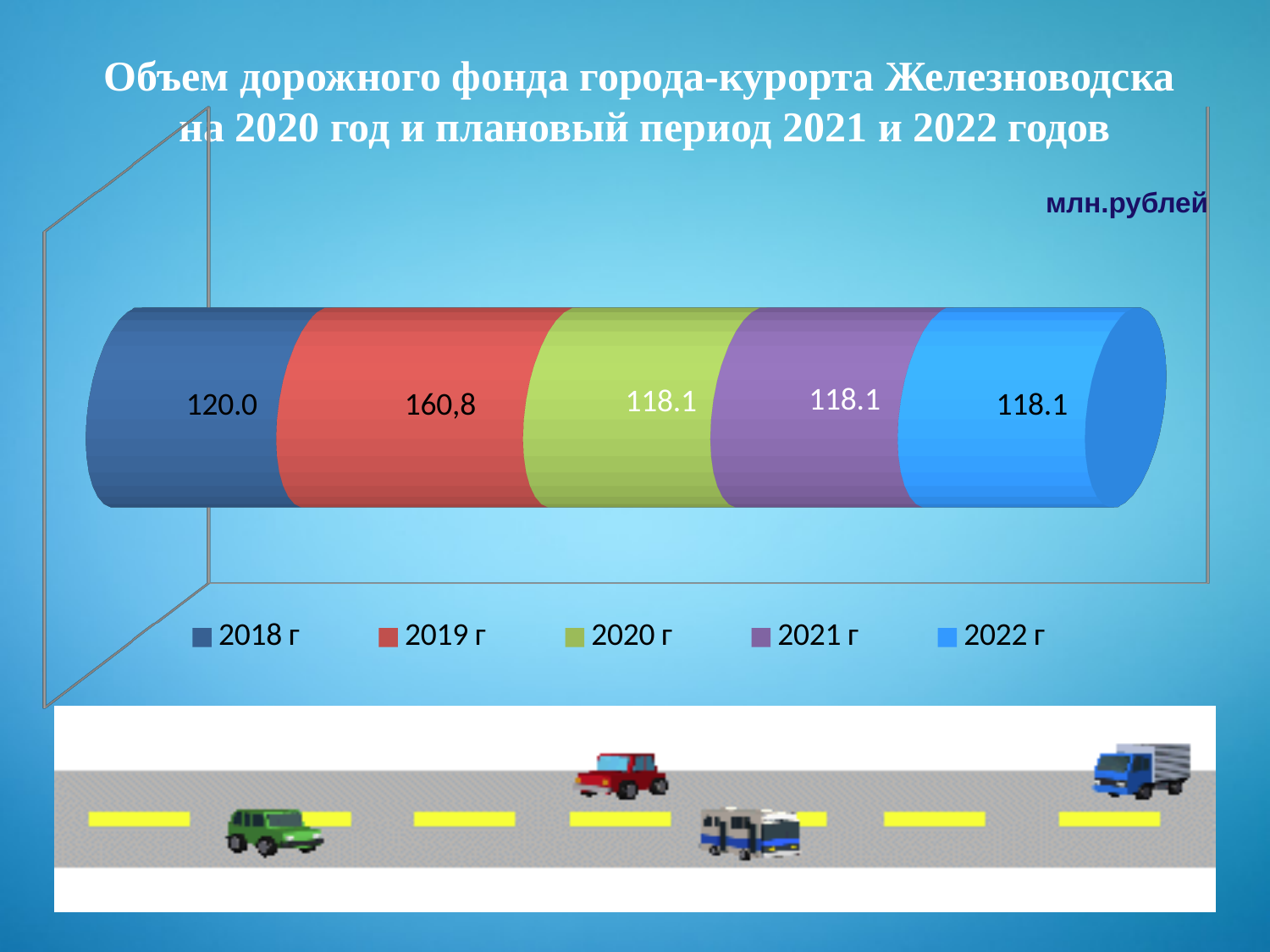
What is the difference between the values for 2019 г and 2018 г? 40.8 What is the value shown for 2020 г? 118.1 How many entries does the legend list? 5 What is the value shown for 2019 г? 160,8 What is the difference between the values for 2019 г and 2021 г? 42.7 Which year has the highest value? 2019 г How many segments make up the stacked bar? 5 What is the value shown for 2018 г? 120.0 Which is larger, the value for 2018 г or the value for 2020 г? 2018 г What unit of measurement is indicated on the chart? млн.рублей What is the value shown for 2022 г? 118.1 What kind of chart is shown on the slide? Bar chart